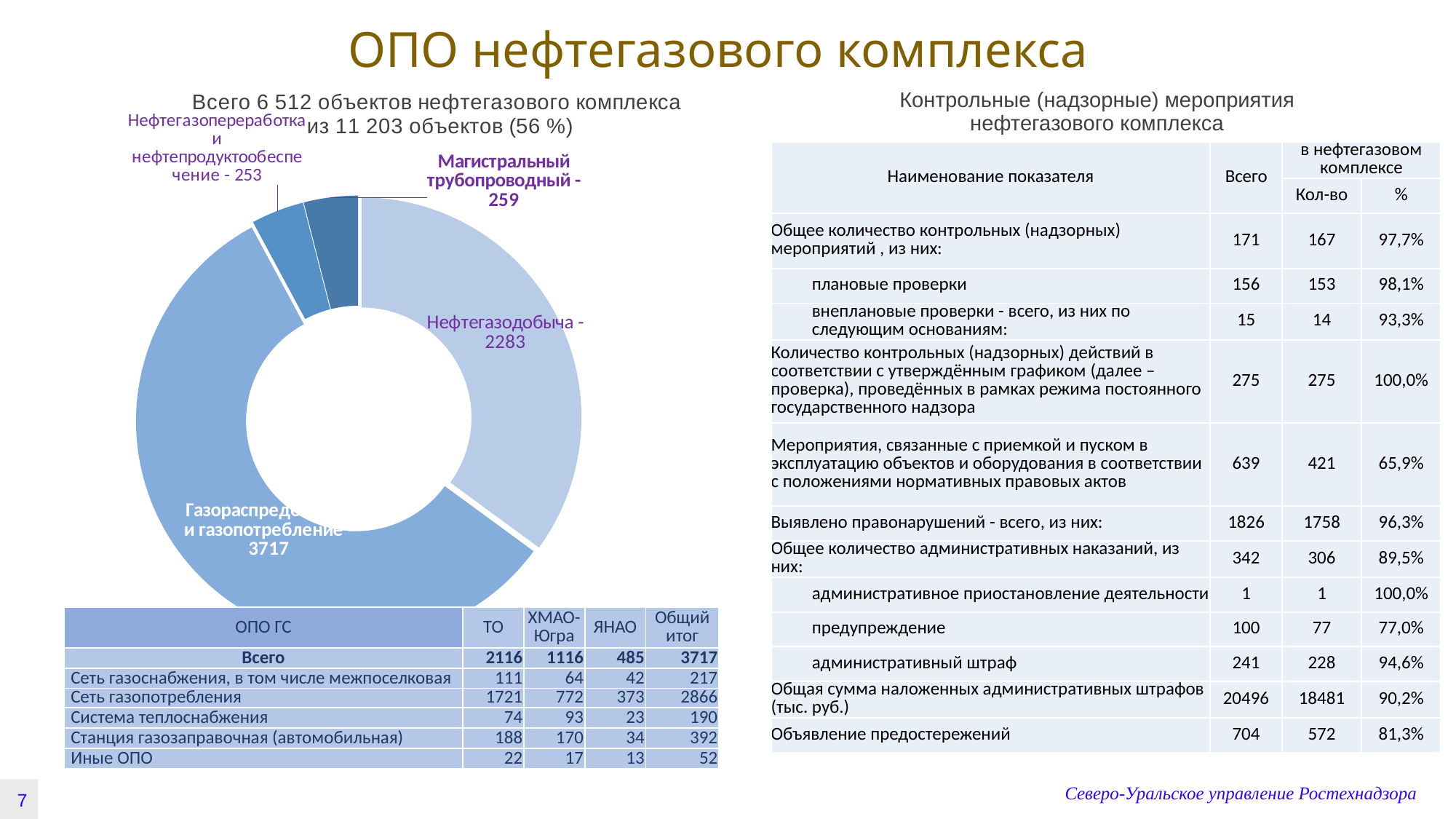
In the donut chart, what is the value for Магистральный трубопроводный? 259 Which category has the smallest slice in the donut chart? Нефтегазопереработка и нефтепродуктообеспечение What is the difference between Газораспределение и газопотребление and Нефтегазодобыча in the donut chart? 1434 What kind of chart is shown on the left of the slide? Donut (pie) chart How many categories are shown in the donut chart? 4 In the donut chart, what is the value for Нефтегазодобыча? 2283 Which is larger in the donut chart: Магистральный трубопроводный or Нефтегазопереработка и нефтепродуктообеспечение? Магистральный трубопроводный According to the donut chart's title, how many objects of the oil and gas complex are there in total? 6 512 What is the difference between Магистральный трубопроводный and Нефтегазопереработка и нефтепродуктообеспечение in the donut chart? 6 In the donut chart, what is the value for Нефтегазопереработка и нефтепродуктообеспечение? 253 Which category has the largest slice in the donut chart? Газораспределение и газопотребление In the donut chart, what is the value for Газораспределение и газопотребление? 3717